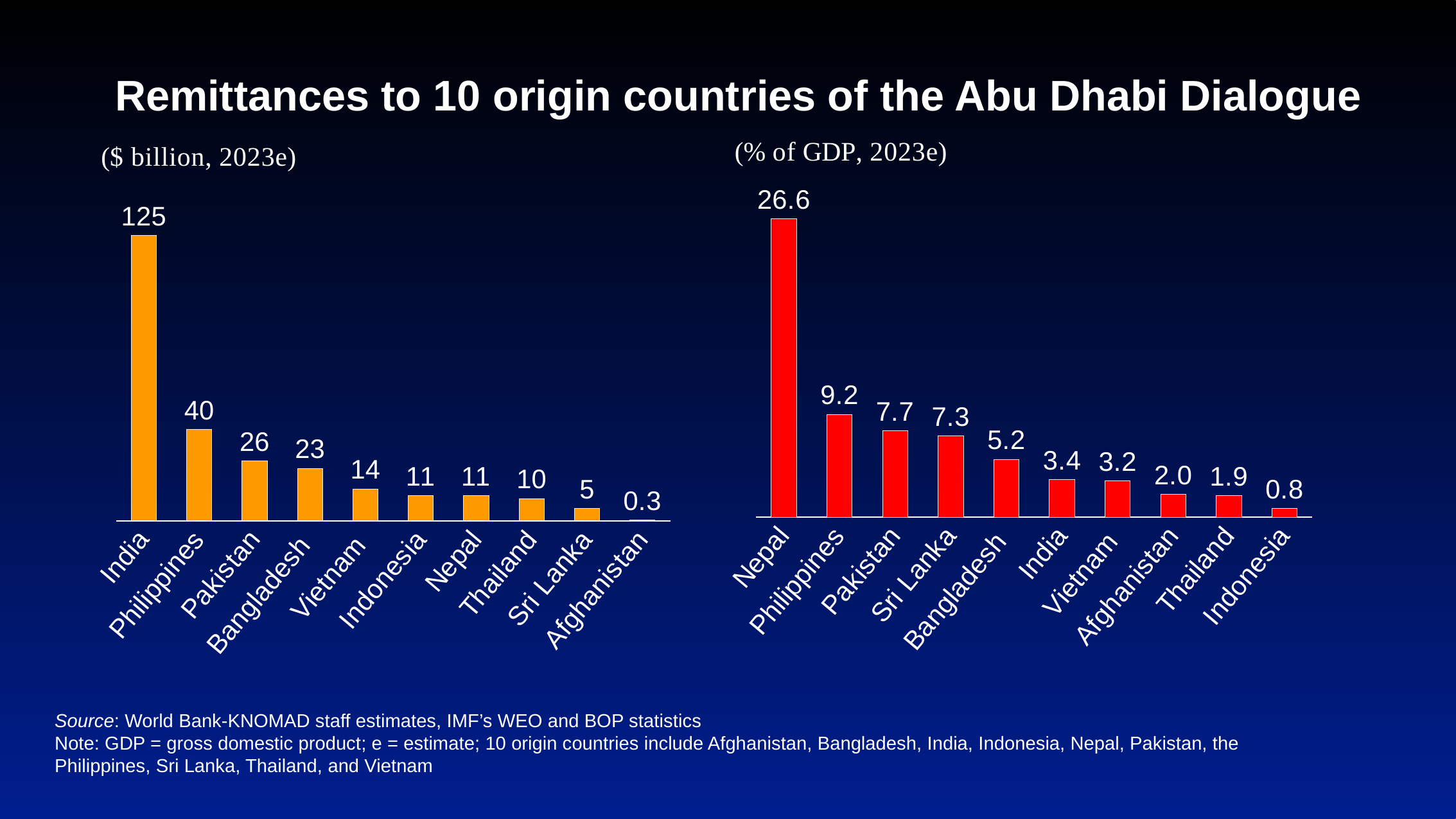
How many countries are shown in the right chart (% of GDP, 2023e)? 10 In the right chart (% of GDP, 2023e), which country has the highest value? Nepal In the left chart ($ billion, 2023e), which country has the lowest value? Afghanistan In the left chart ($ billion, 2023e), what is the value for Sri Lanka? 5 What kind of chart is the left chart ($ billion, 2023e)? Bar chart In the left chart ($ billion, 2023e), which is larger, the value for Pakistan or the value for Bangladesh? Pakistan In the right chart (% of GDP, 2023e), what is the difference between the values for Nepal and the Philippines? 17.4 In the right chart (% of GDP, 2023e), what is the value for Thailand? 1.9 In the right chart (% of GDP, 2023e), which country has the lowest value? Indonesia In the left chart ($ billion, 2023e), what is the value for India? 125 In the right chart (% of GDP, 2023e), what is the value for Nepal? 26.6 In the left chart ($ billion, 2023e), what is the difference between the values for India and the Philippines? 85